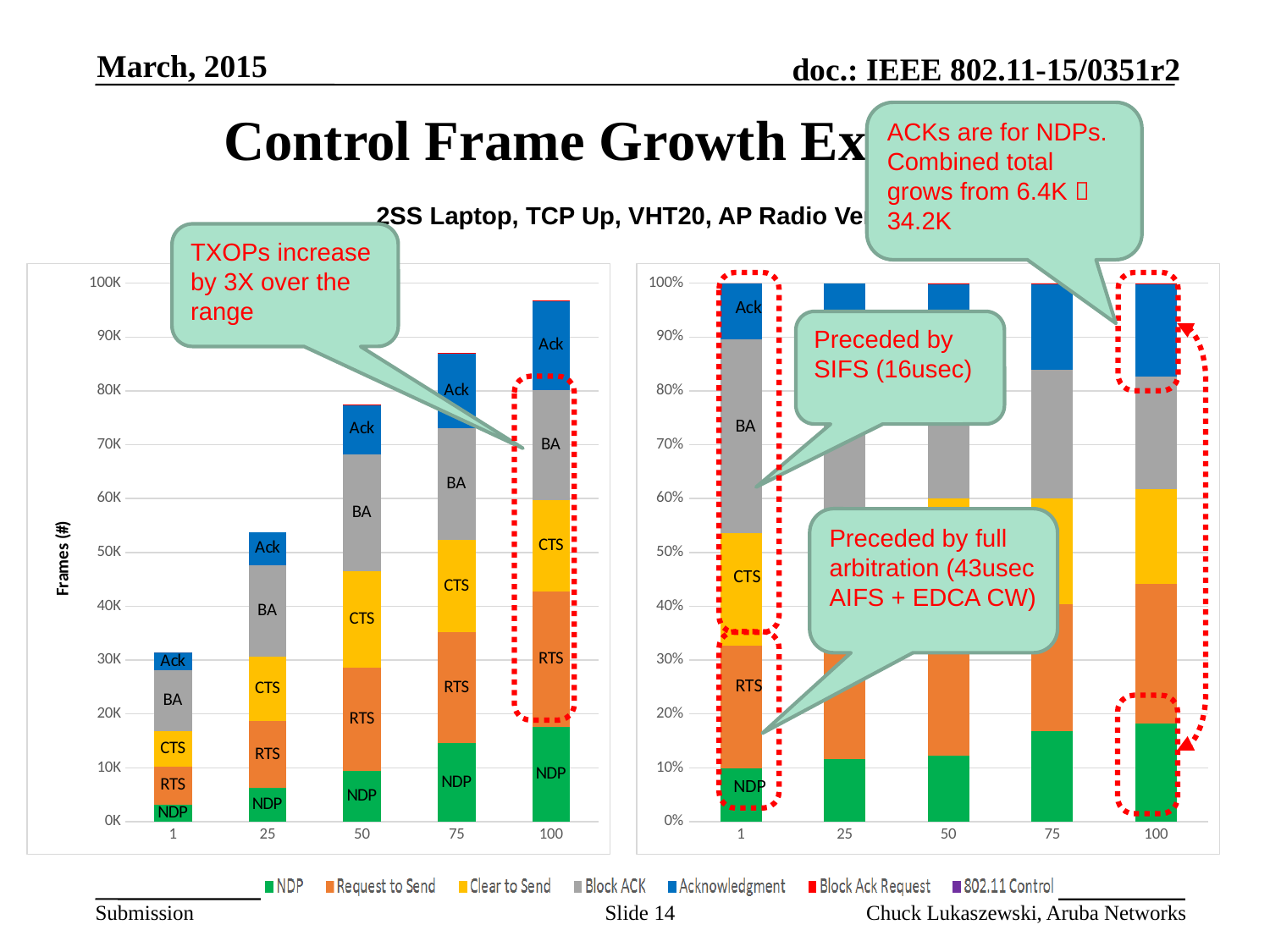
In the left chart, is the total stacked bar for category 50 greater or less than 70K? greater In the left chart, which category has the shortest stacked bar? 1 In the left chart, do the total frame counts rise or fall as the x-axis value increases from 1 to 100? rise In the right chart (percentage chart), is the NDP share for category 100 greater or less than 10%? greater Which colour represents NDP in the legend? green How many series does the shared legend list? 7 In the left chart, which category has the tallest stacked bar? 100 What kind of chart is the left chart (Frames (#))? stacked bar chart How many categories are shown on the x axis of the left chart? 5 In the left chart, which stacked bar is taller, category 25 or category 75? 75 In the left chart, is the total stacked bar for category 100 greater or less than 90K? greater